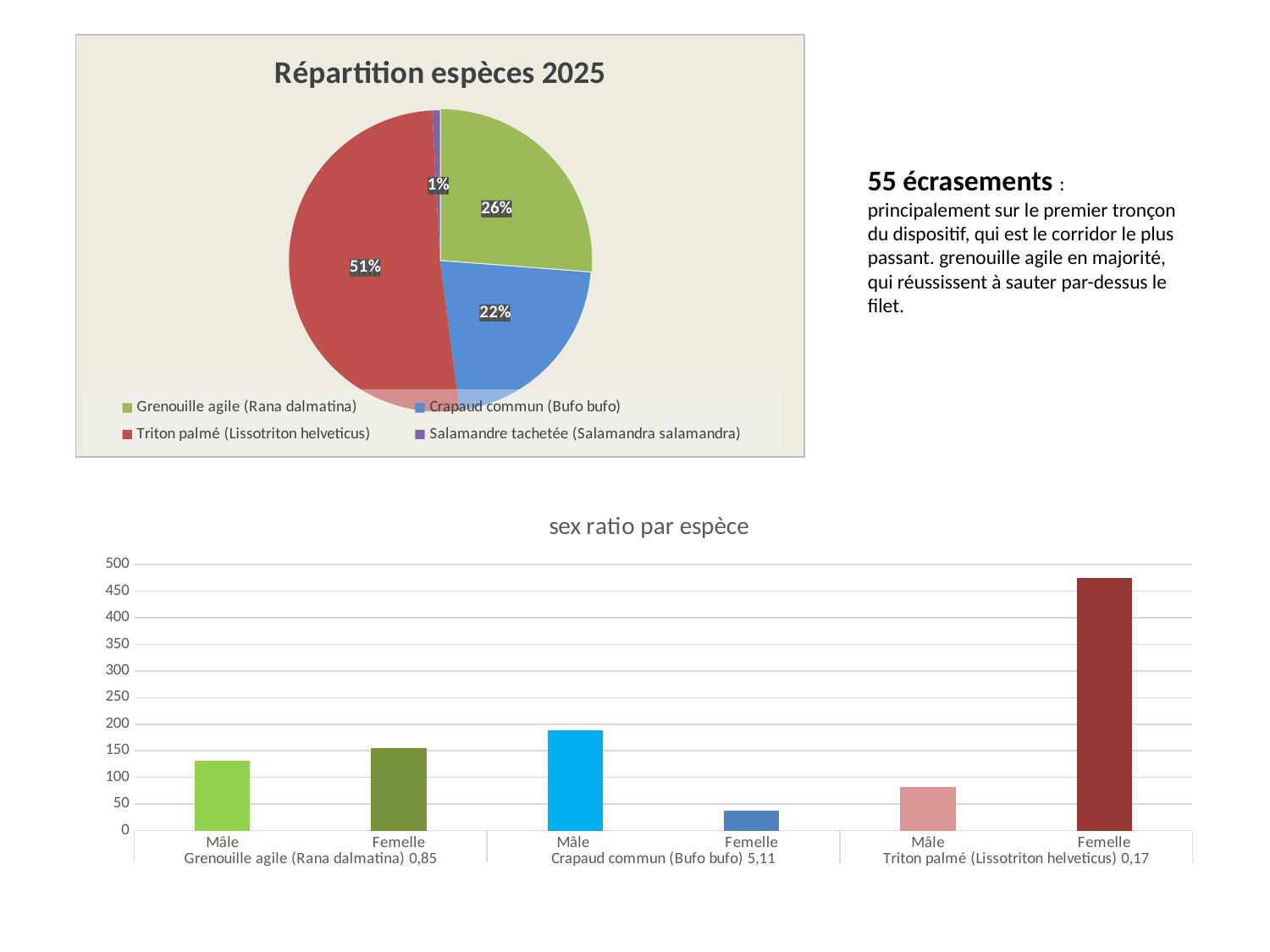
In the pie chart 'Répartition espèces 2025', which species has the largest share? Triton palmé (Lissotriton helveticus) In the chart 'sex ratio par espèce', which bar is the tallest? Femelle, Triton palmé (Lissotriton helveticus) In the pie chart 'Répartition espèces 2025', what share is Grenouille agile (Rana dalmatina)? 26% In the pie chart 'Répartition espèces 2025', which species has the smallest share? Salamandre tachetée (Salamandra salamandra) In the chart 'sex ratio par espèce', which bar is the shortest? Femelle, Crapaud commun (Bufo bufo) In the pie chart 'Répartition espèces 2025', what share is Crapaud commun (Bufo bufo)? 22% What kind of chart is 'sex ratio par espèce'? bar chart In the pie chart 'Répartition espèces 2025', how many percentage points larger is the Triton palmé share than the Grenouille agile share? 25 In the chart 'sex ratio par espèce', is the value for Femelle Triton palmé greater or less than 450? greater In the pie chart 'Répartition espèces 2025', what share is Triton palmé (Lissotriton helveticus)? 51% In the pie chart 'Répartition espèces 2025', how many species are listed in the legend? 4 In the chart 'sex ratio par espèce', which is larger: Mâle or Femelle for Crapaud commun (Bufo bufo)? Mâle